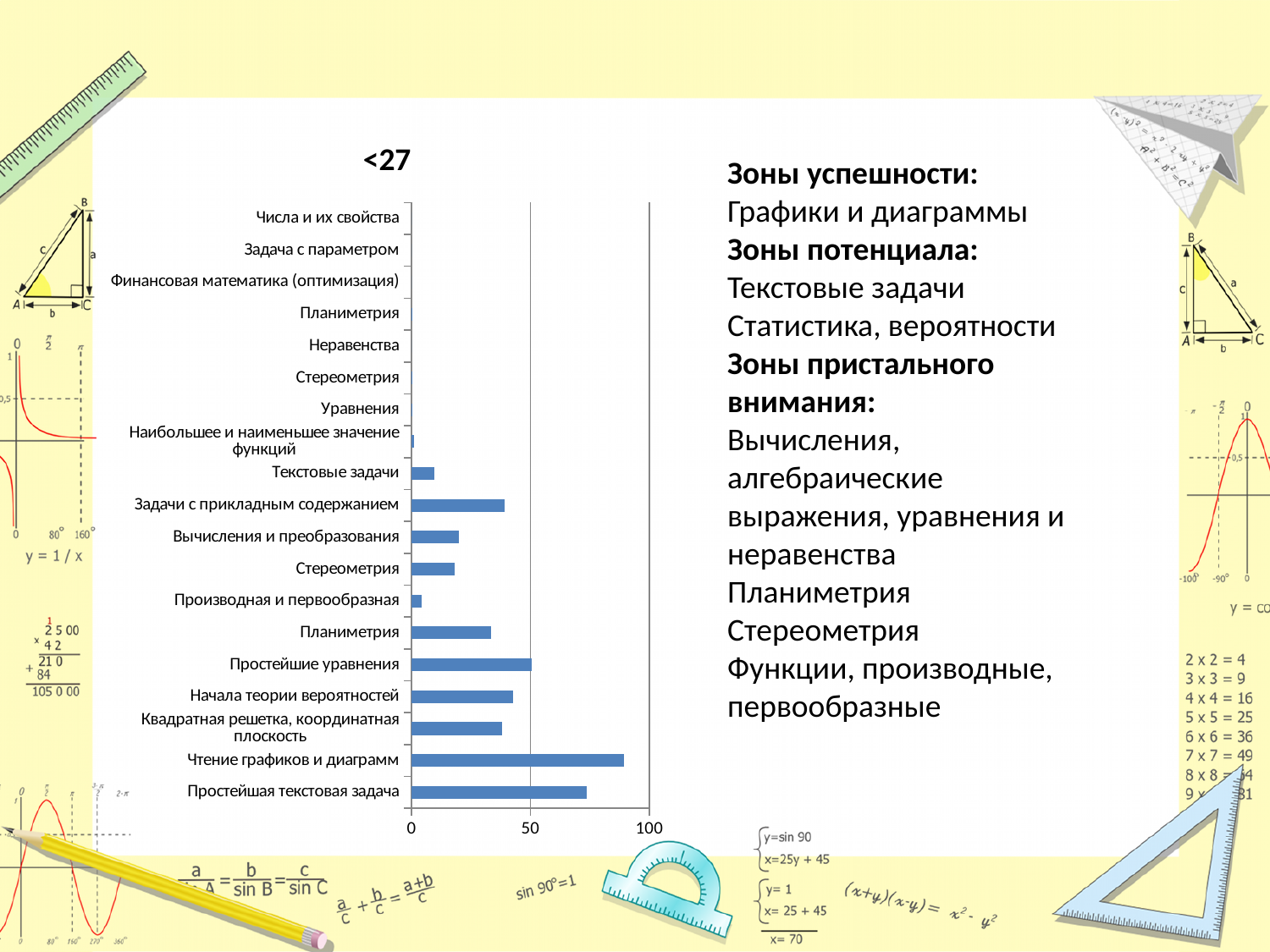
Is the value for Чтение графиков и диаграмм greater or less than 50? greater What is the maximum value shown on the horizontal axis of the chart? 100 Which is larger: the value for Текстовые задачи or the value for Задачи с прикладным содержанием? Задачи с прикладным содержанием Is the value for Начала теории вероятностей greater or less than 50? less Which is larger: the value for Производная и первообразная or the value for Простейшие уравнения? Простейшие уравнения Is the value for Простейшая текстовая задача greater or less than 50? greater What kind of chart is shown on the slide? bar chart Which is larger: the value for Чтение графиков и диаграмм or the value for Простейшая текстовая задача? Чтение графиков и диаграмм What is the title of the chart? <27 How many categories are plotted in the chart? 19 Which category has the highest value in the chart? Чтение графиков и диаграмм